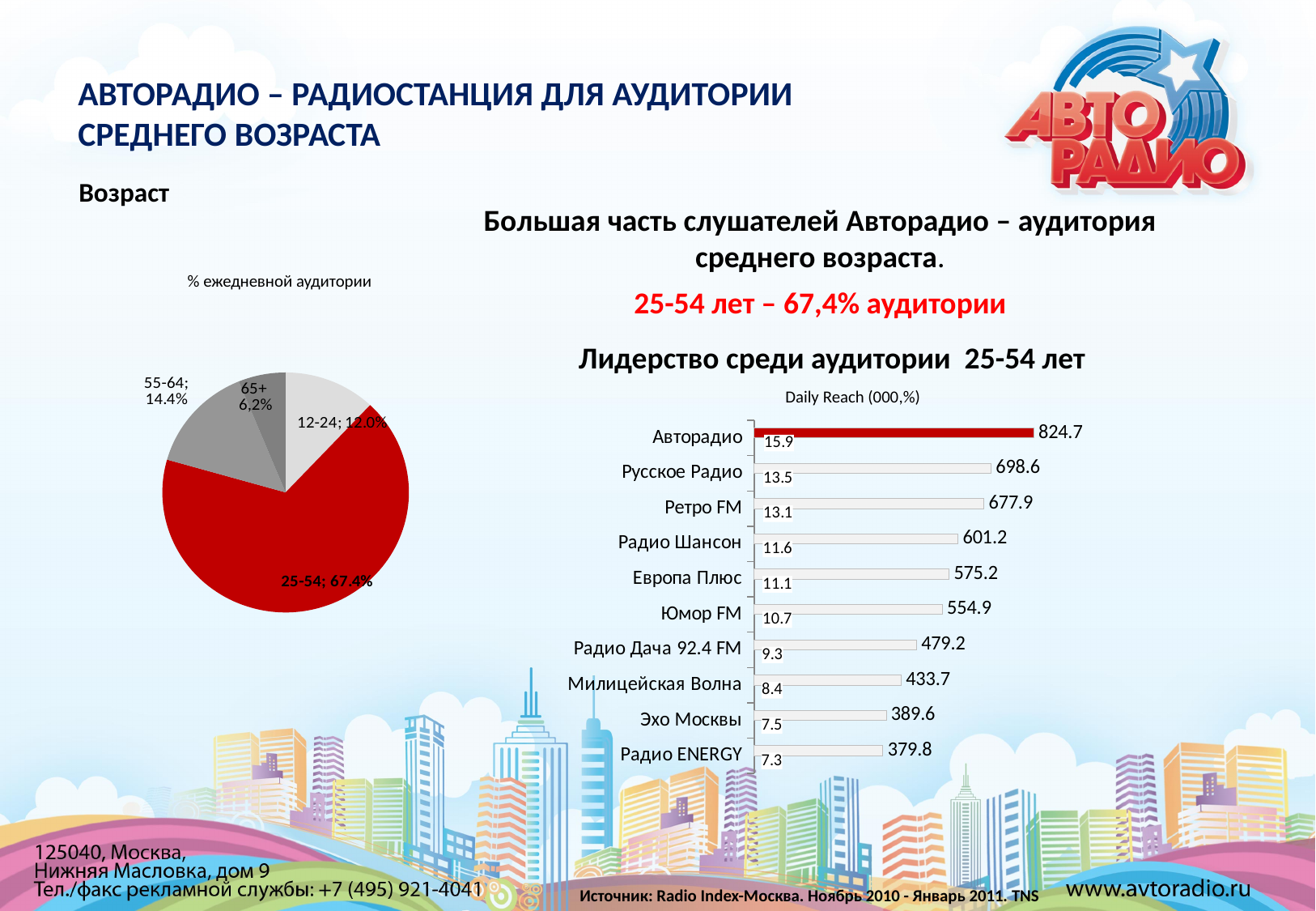
In the pie chart '% ежедневной аудитории', what share of the daily audience is aged 25-54? 67.4% What kind of chart is the 'Daily Reach (000,%)' chart? Bar chart In the 'Daily Reach (000,%)' chart, which station has the highest daily reach? Авторадио In the pie chart '% ежедневной аудитории', how many age groups are shown? 4 In the pie chart '% ежедневной аудитории', what is the difference between the shares of the 12-24 and 65+ groups? 5.8% In the 'Daily Reach (000,%)' chart, how many radio stations are listed? 10 In the 'Daily Reach (000,%)' chart, what is the difference in daily reach (thousands) between Авторадио and Русское Радио? 126.1 In the pie chart '% ежедневной аудитории', what share of the daily audience is aged 55-64? 14.4% In the 'Daily Reach (000,%)' chart, what is the daily reach percentage for Радио Шансон? 11.6 In the 'Daily Reach (000,%)' chart, what is the daily reach in thousands for Русское Радио? 698.6 In the pie chart '% ежедневной аудитории', which age group has the smallest share? 65+ In the 'Daily Reach (000,%)' chart, which station has the lowest daily reach? Радио ENERGY